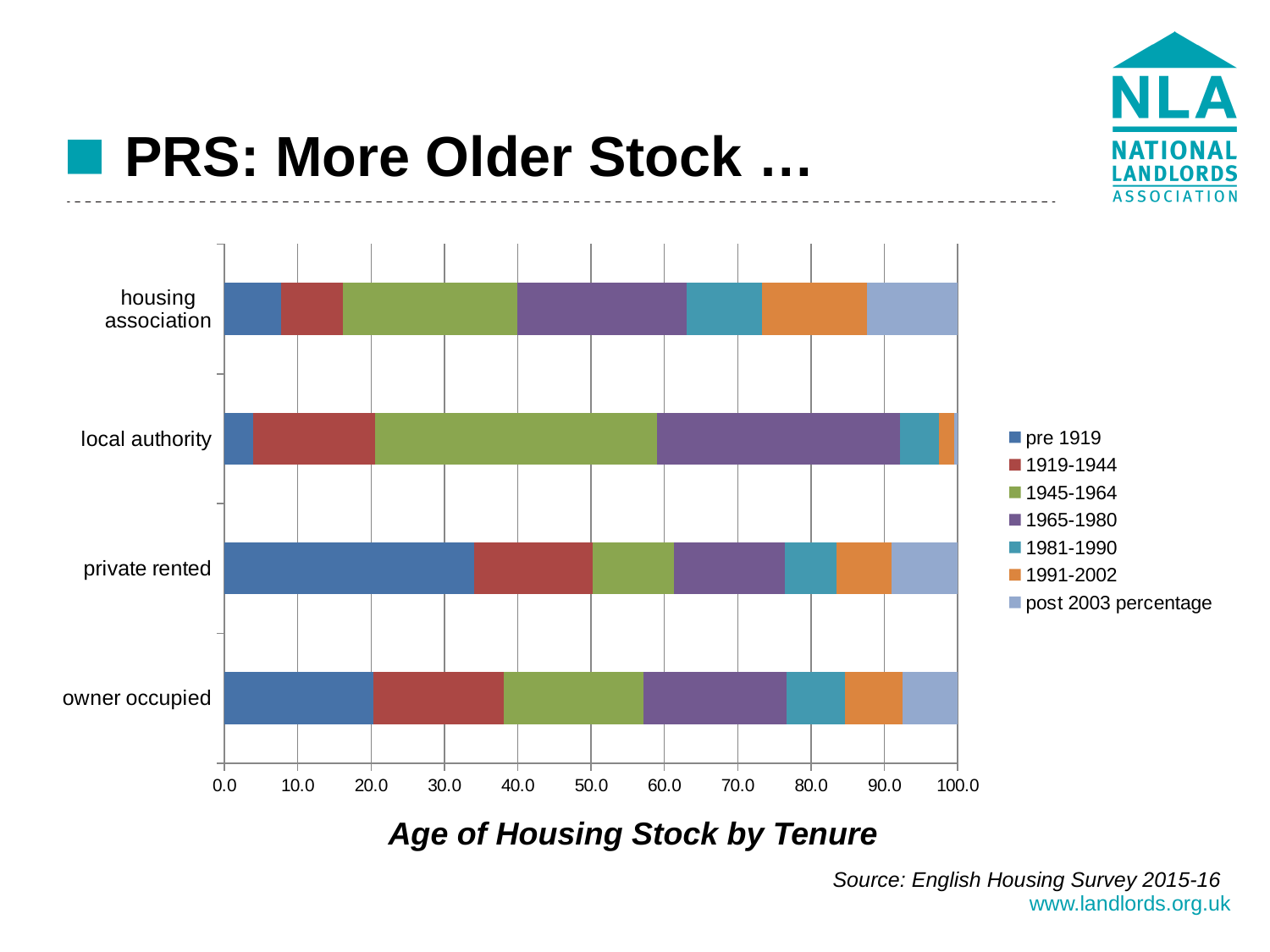
Is the 1945-1964 segment for local authority greater or less than 30? greater How many tenure categories are plotted on the chart? 4 Which is larger: the pre 1919 segment for private rented or for owner occupied? private rented Which is larger: the 1945-1964 segment for local authority or for private rented? local authority What is the title of the chart? Age of Housing Stock by Tenure Is the pre 1919 segment for local authority greater or less than 10? less How many series does the legend list? 7 What kind of chart is shown on the slide? bar chart Is the pre 1919 segment for private rented greater or less than 30? greater Which tenure has the largest 1965-1980 segment? local authority Which tenure has the smallest pre 1919 segment? local authority Which tenure has the largest pre 1919 segment? private rented